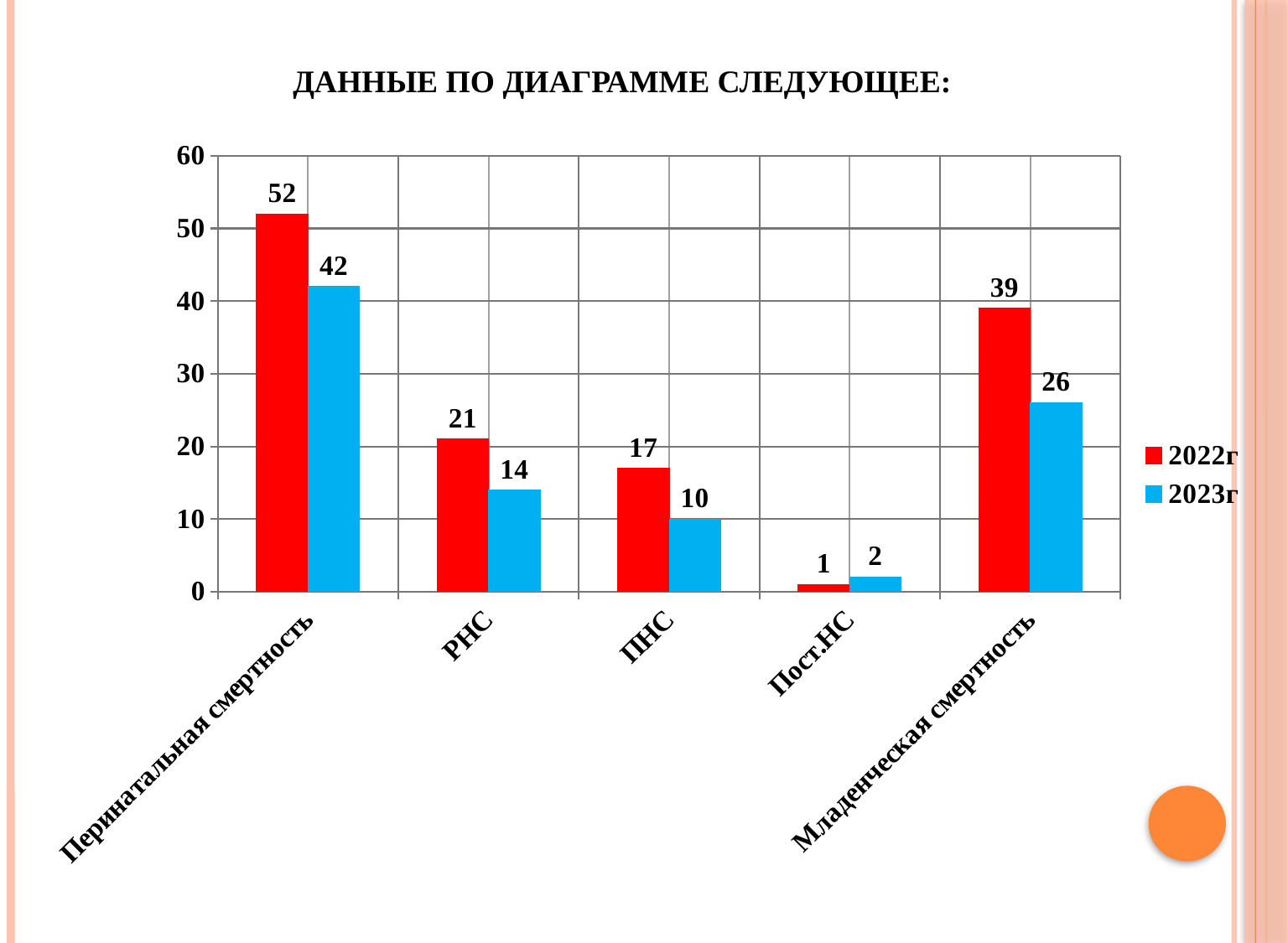
How many series does the legend list? 2 How many categories are shown on the x axis? 5 Which is larger for Пост.НС: the 2022г value or the 2023г value? 2023г What is the value for ПНС in the 2023г series? 10 What is the difference between the 2022г and 2023г values for Перинатальная смертность? 10 What is the value for Младенческая смертность in the 2023г series? 26 What is the difference between the 2022г and 2023г values for РНС? 7 What is the value for Перинатальная смертность in the 2022г series? 52 Which category has the lowest value in the 2023г series? Пост.НС Which category has the highest value in the 2022г series? Перинатальная смертность Which colour represents the 2023г series? Blue What kind of chart is shown on the slide? Bar chart